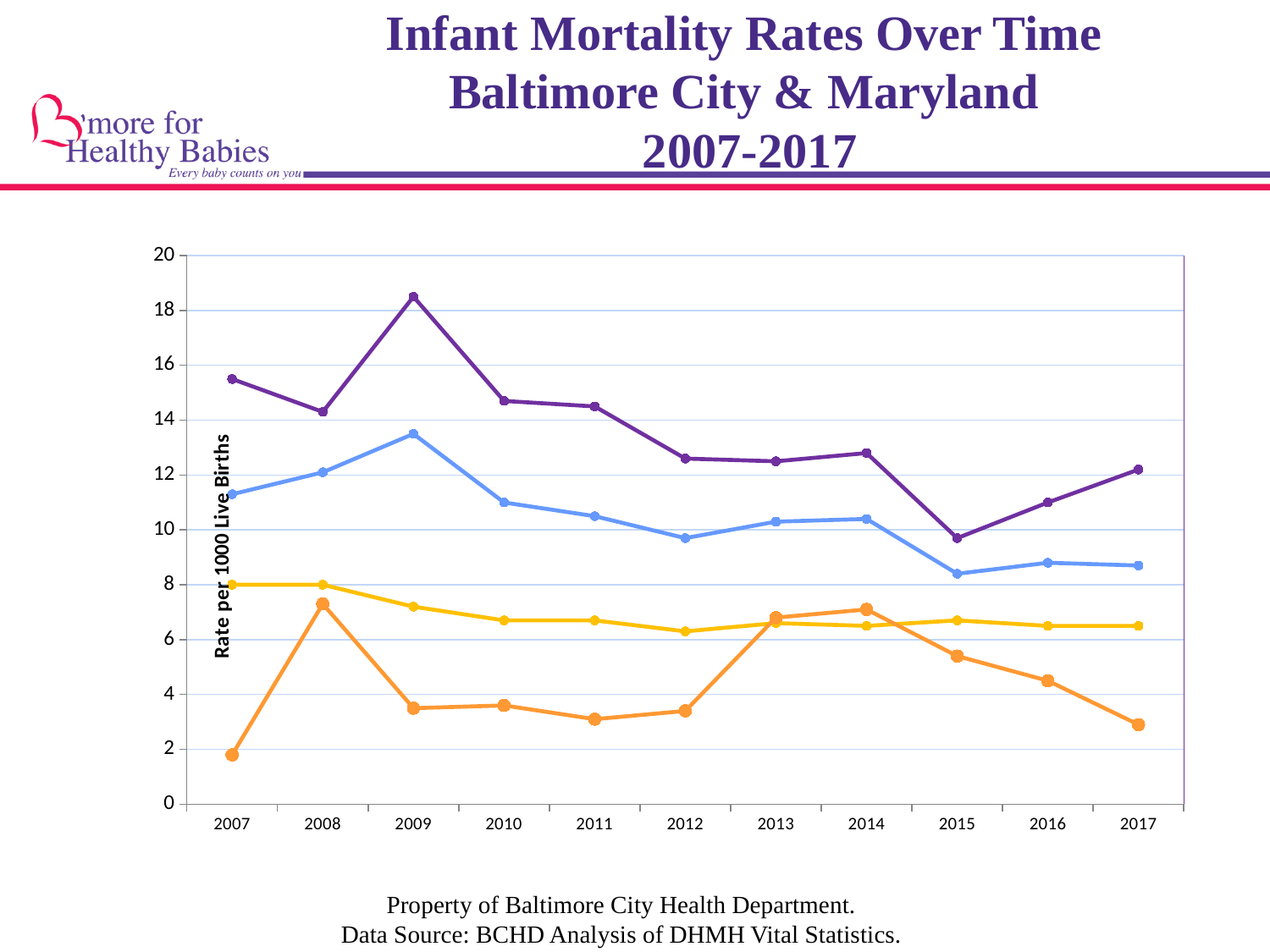
What is the label of the y axis? Rate per 1000 Live Births Is the value of the blue line in 2015 greater or less than 10? less How many lines are plotted on the chart? 4 What kind of chart is shown on the slide? line chart In which year does the dark purple line reach its highest value? 2009 Is the value of the orange line in 2011 greater or less than 4? less Is the value of the dark purple line in 2009 greater or less than 18? greater Does the dark purple line overall rise or fall from 2007 to 2017? fall How many years are plotted along the x axis? 11 In which year does the orange line reach its lowest value? 2007 What is the title of the slide? Infant Mortality Rates Over Time Baltimore City & Maryland 2007-2017